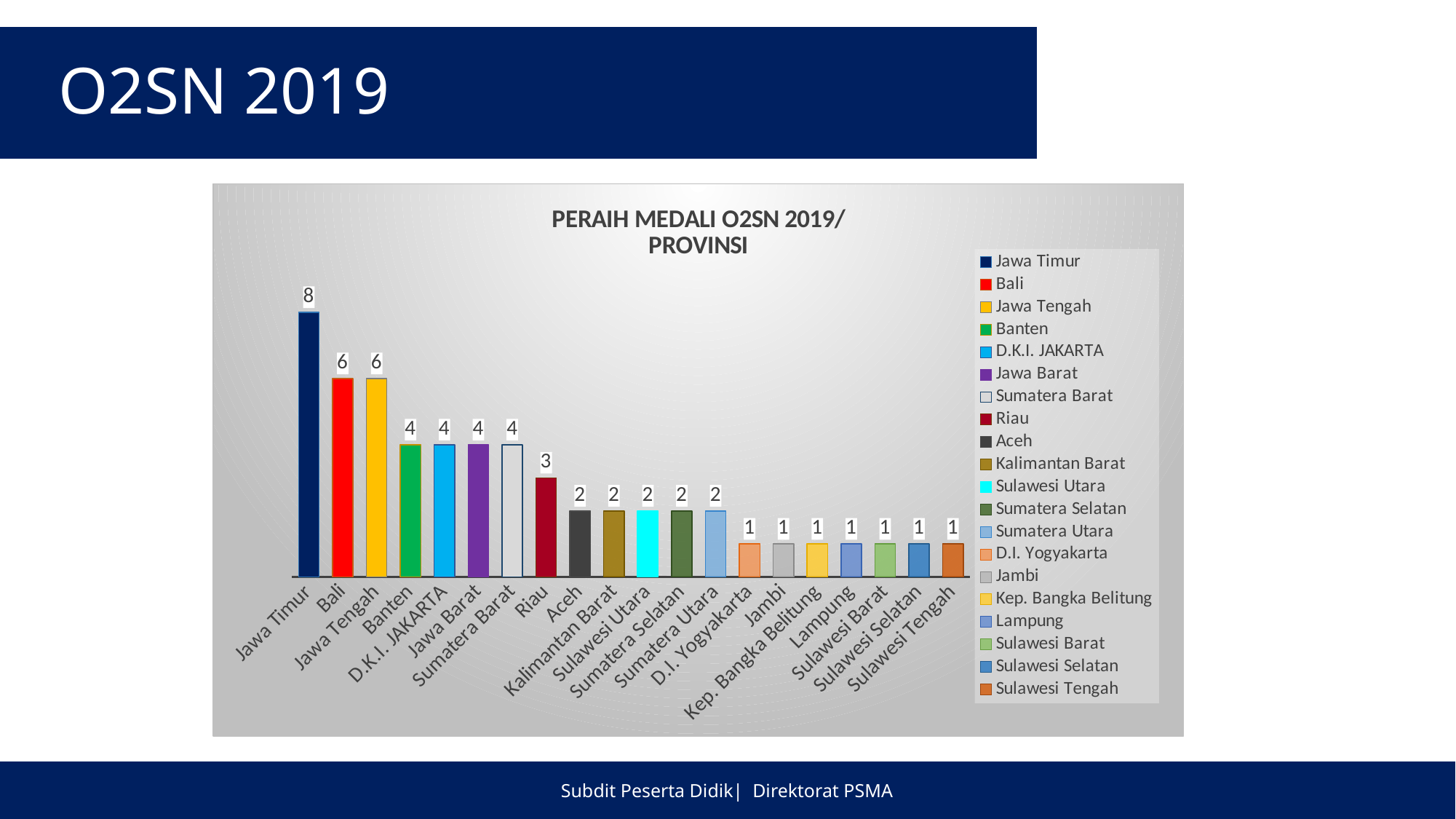
How many entries does the chart's legend list? 20 What is the value shown for Riau? 3 Which province has the highest value in the chart? Jawa Timur What is the title of the chart? PERAIH MEDALI O2SN 2019/ PROVINSI What is the value shown for Kalimantan Barat? 2 What is the difference between the values for Banten and Aceh? 2 What is the difference between the values for Jawa Timur and Bali? 2 Which has a larger value, Riau or Sumatera Utara? Riau How many provinces are shown on the x axis of the chart? 20 How many medals does Jawa Timur have according to the chart? 8 What is the value shown for Lampung? 1 What kind of chart is shown on the slide? bar chart